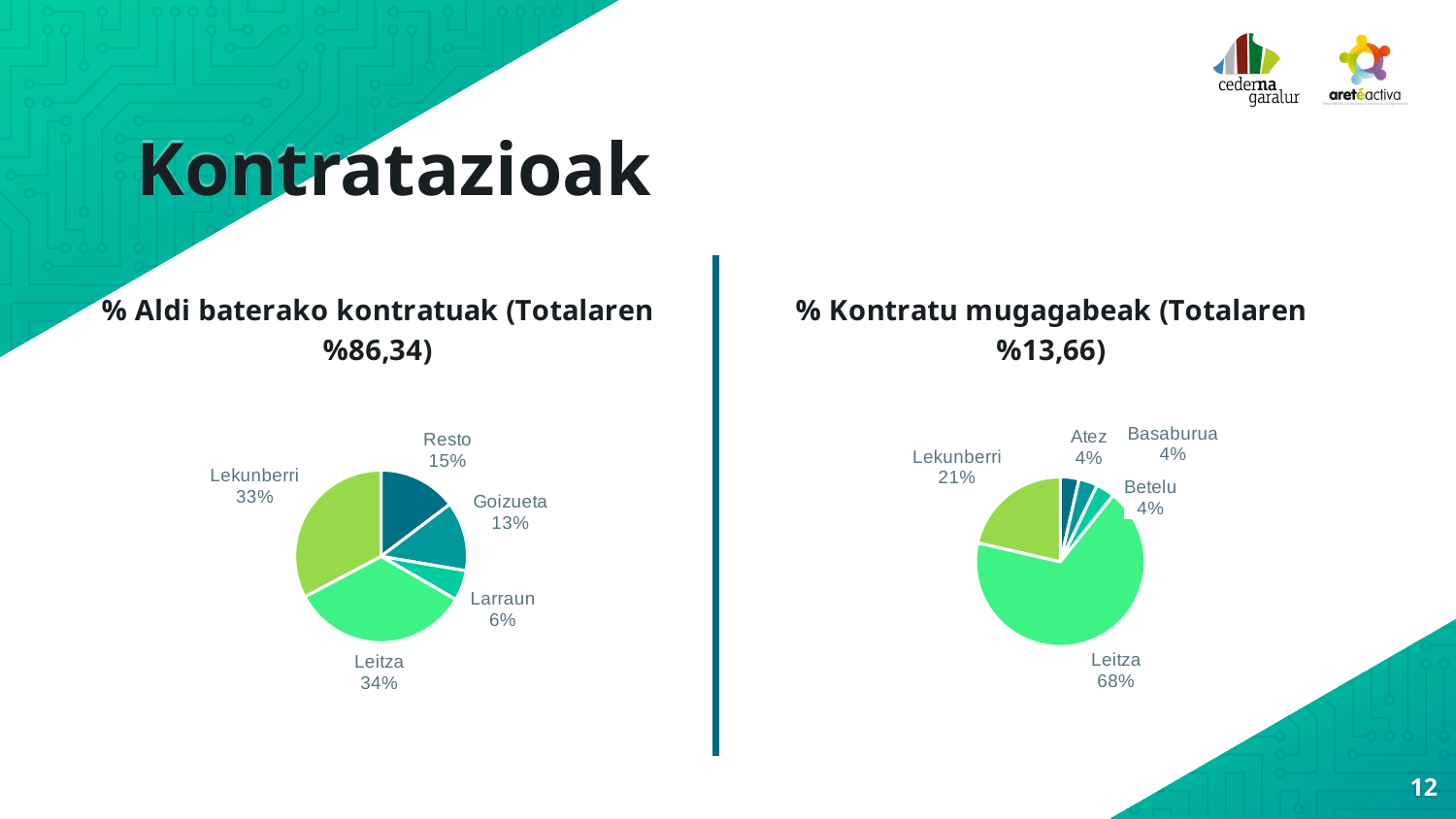
In the left pie chart (% Aldi baterako kontratuak), which is larger, Resto or Goizueta? Resto In the left pie chart (% Aldi baterako kontratuak), which category has the smallest share? Larraun In the right pie chart (% Kontratu mugagabeak), which category has the largest share? Leitza In the left pie chart (% Aldi baterako kontratuak), what share does Goizueta have? 13% In the left pie chart (% Aldi baterako kontratuak), what is the difference between the shares of Resto and Larraun? 9% In the right pie chart (% Kontratu mugagabeak), what share does Betelu have? 4% What is the title of the left chart on the slide? % Aldi baterako kontratuak (Totalaren %86,34) In the left pie chart (% Aldi baterako kontratuak), what share does Leitza have? 34% In the left pie chart (% Aldi baterako kontratuak), how many slices are there? 5 In the right pie chart (% Kontratu mugagabeak), what share does Lekunberri have? 21% In the right pie chart (% Kontratu mugagabeak), what is the difference between the shares of Leitza and Lekunberri? 47% What type of chart is used on the right side of the slide (% Kontratu mugagabeak)? Pie chart